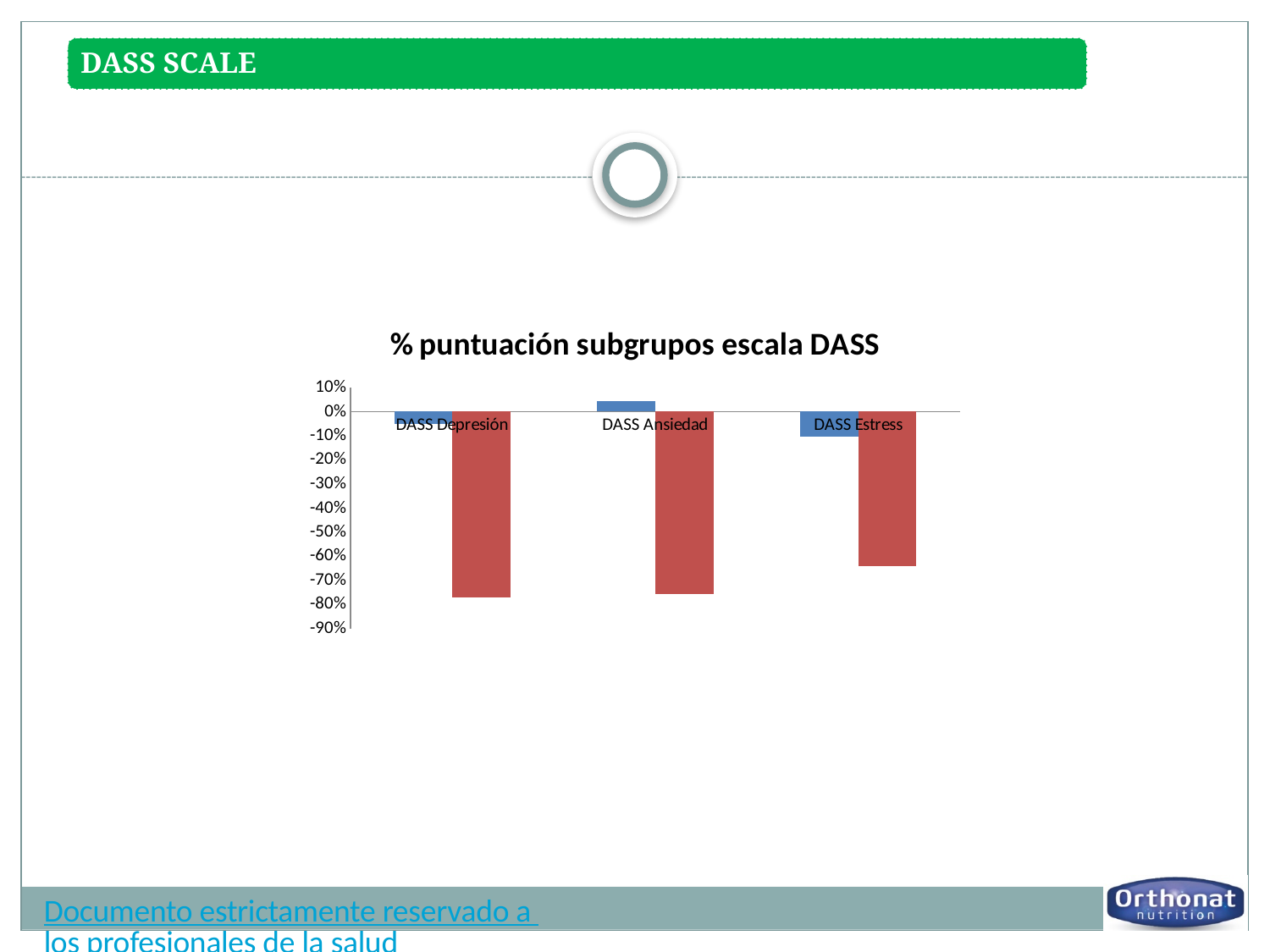
How many bars are plotted for each category in the chart? 2 How many categories are shown on the x axis of the chart? 3 Which is larger, the red bar value for DASS Estress or the red bar value for DASS Depresión? DASS Estress Is the value of the red bar for DASS Ansiedad greater or less than -70%? less Is the value of the red bar for DASS Estress greater or less than -70%? greater What is the title of the chart? % puntuación subgrupos escala DASS Which category has the red bar with the highest (least negative) value? DASS Estress Is the value of the red bar for DASS Estress greater or less than -60%? less What kind of chart is shown on the slide? bar chart